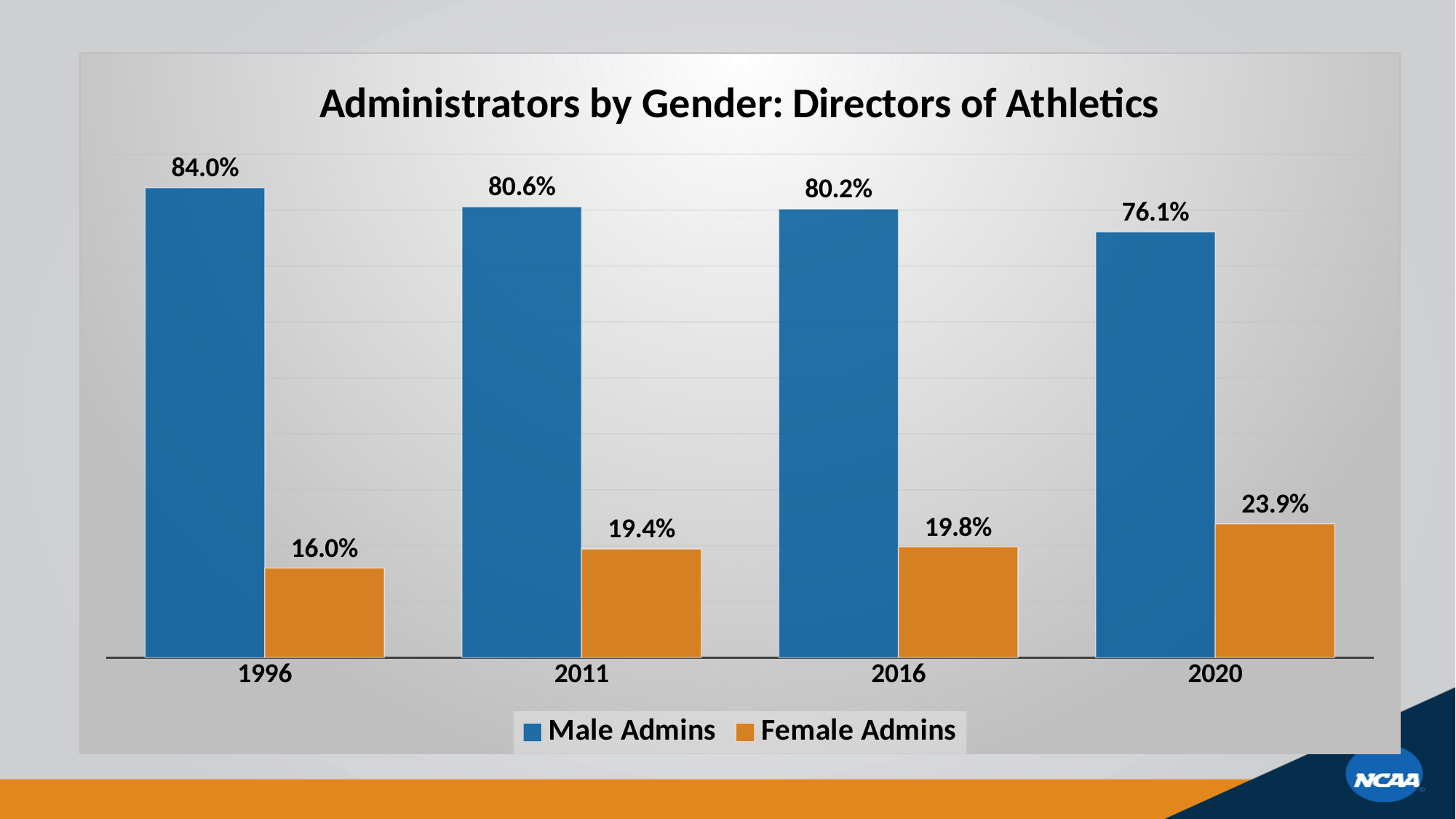
What is the value for Female Admins in 2011? 19.4% In which year is the Female Admins value highest? 2020 What kind of chart is shown on the slide? Bar chart How many series does the legend list? 2 Do the Male Admins values rise or fall from 1996 to 2020? Fall What is the value for Male Admins in 1996? 84.0% What is the value for Male Admins in 2016? 80.2% What is the value for Female Admins in 2020? 23.9% Which is larger: the Female Admins value in 2016 or in 1996? 2016 What is the difference between the Male Admins and Female Admins values in 2020? 52.2% How many years are shown on the x axis? 4 In which year is the Male Admins value lowest? 2020